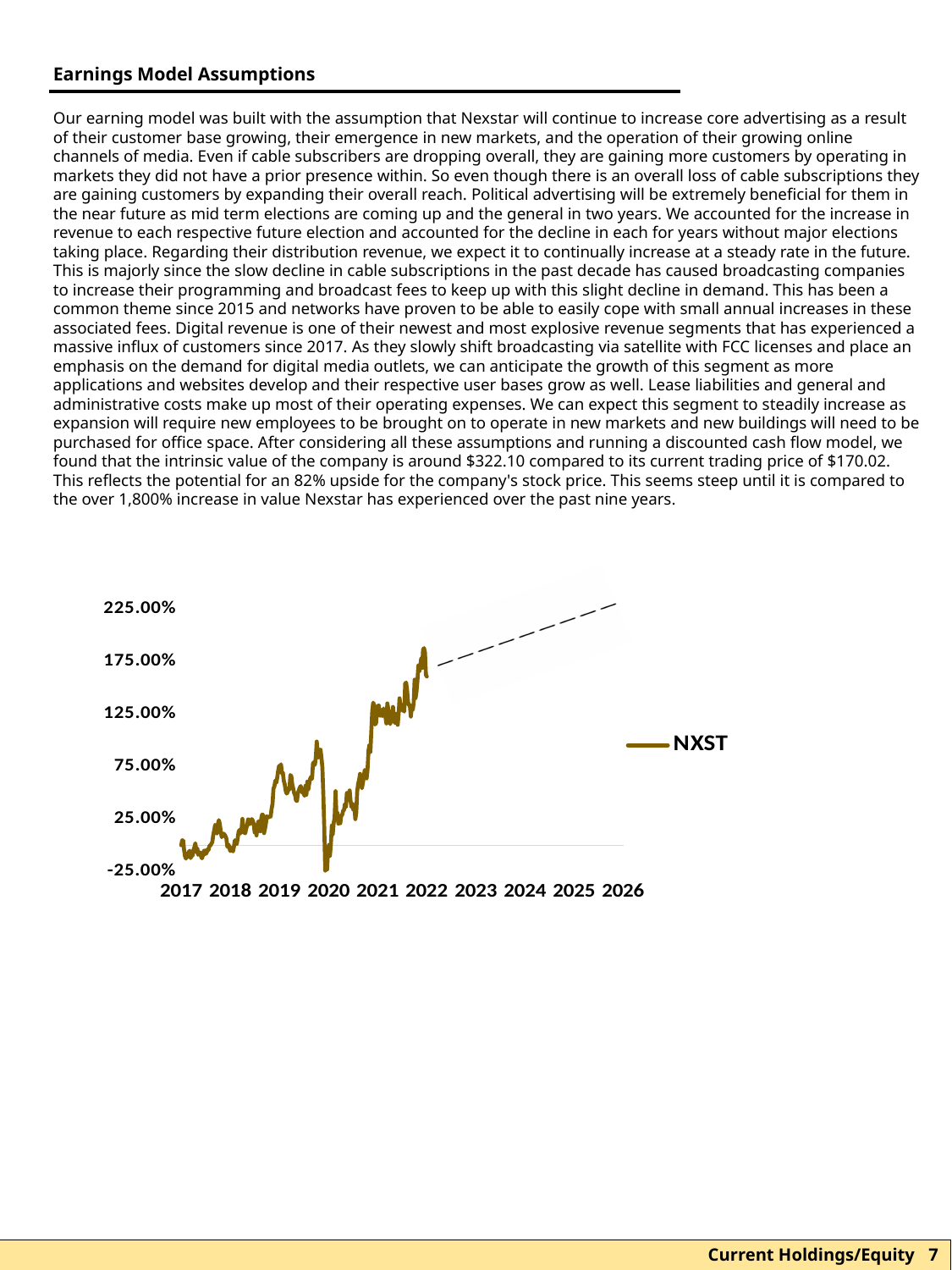
What is the first year labelled on the x axis of the chart? 2017 Is the NXST value at the start of 2022 greater or less than 125.00%? greater How many years are labelled on the x axis of the chart? 10 What kind of chart is shown on the slide? line chart What is the highest value labelled on the y axis of the chart? 225.00% What is the name of the series shown in the chart legend? NXST Overall, does the NXST line rise or fall from 2017 to 2022? rise How many series does the chart legend list? 1 Is the NXST value at the start of 2022 larger or smaller than the value at the start of 2017? larger Is the projected NXST value at 2026 (end of the dashed line) greater or less than 175.00%? greater Is the NXST value at the start of 2017 greater or less than 25.00%? less